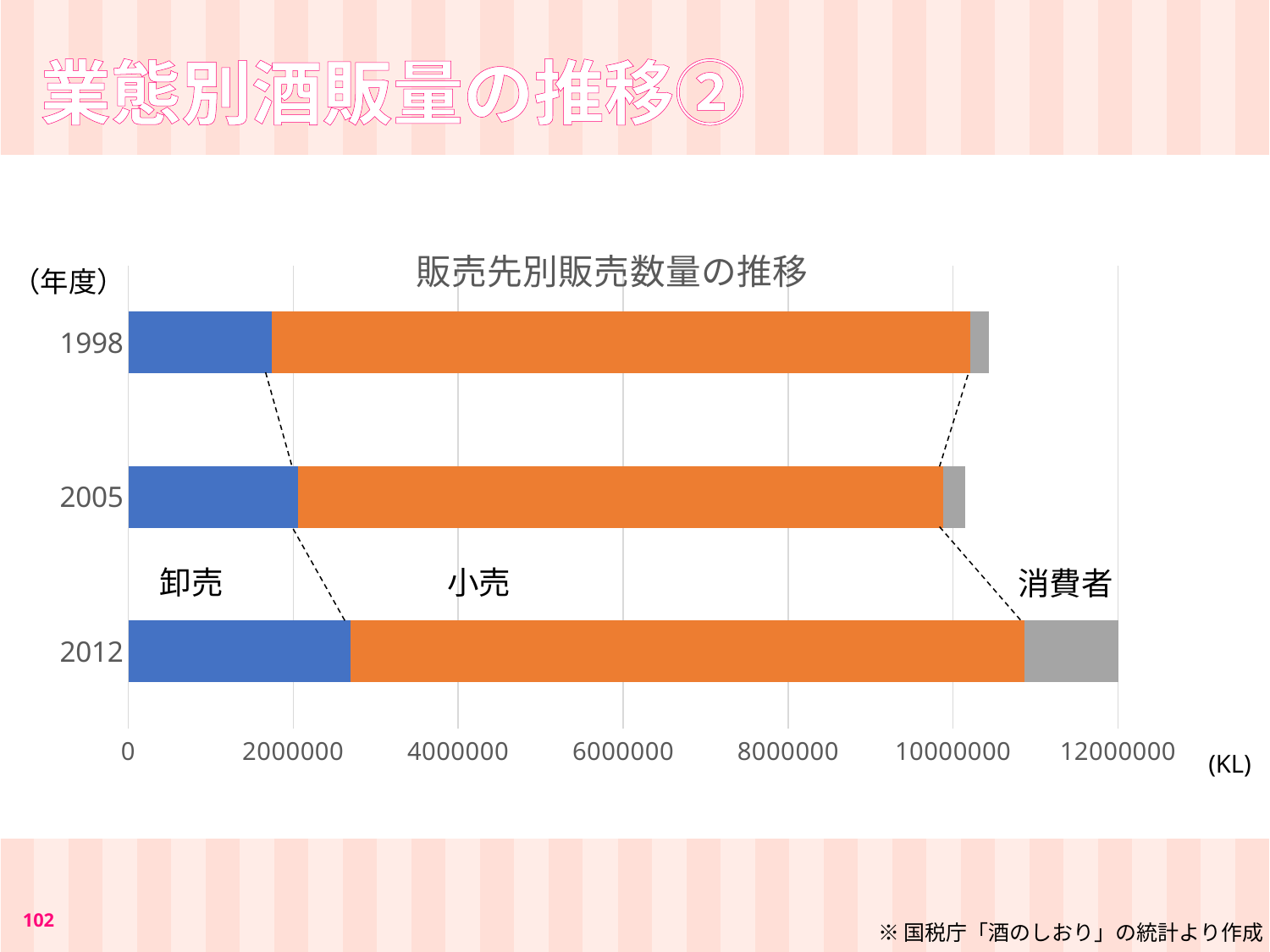
How many series (segments) does the chart show? 3 Which is larger, the 消費者 value for 2012 or for 1998? 2012 What is the title of the chart? 販売先別販売数量の推移 Is the 卸売 value for 1998 greater or less than 2000000? less Which year has the smallest 卸売 value? 1998 Is the 卸売 value for 2012 greater or less than 2000000? greater Does the 卸売 value rise or fall from 1998 to 2012? rise Which year has the largest total bar? 2012 How many years (categories) are plotted on the chart? 3 Is the total value of the 1998 bar greater or less than 10000000? greater What unit is shown for the horizontal axis? KL What kind of chart is shown on the slide? stacked bar chart